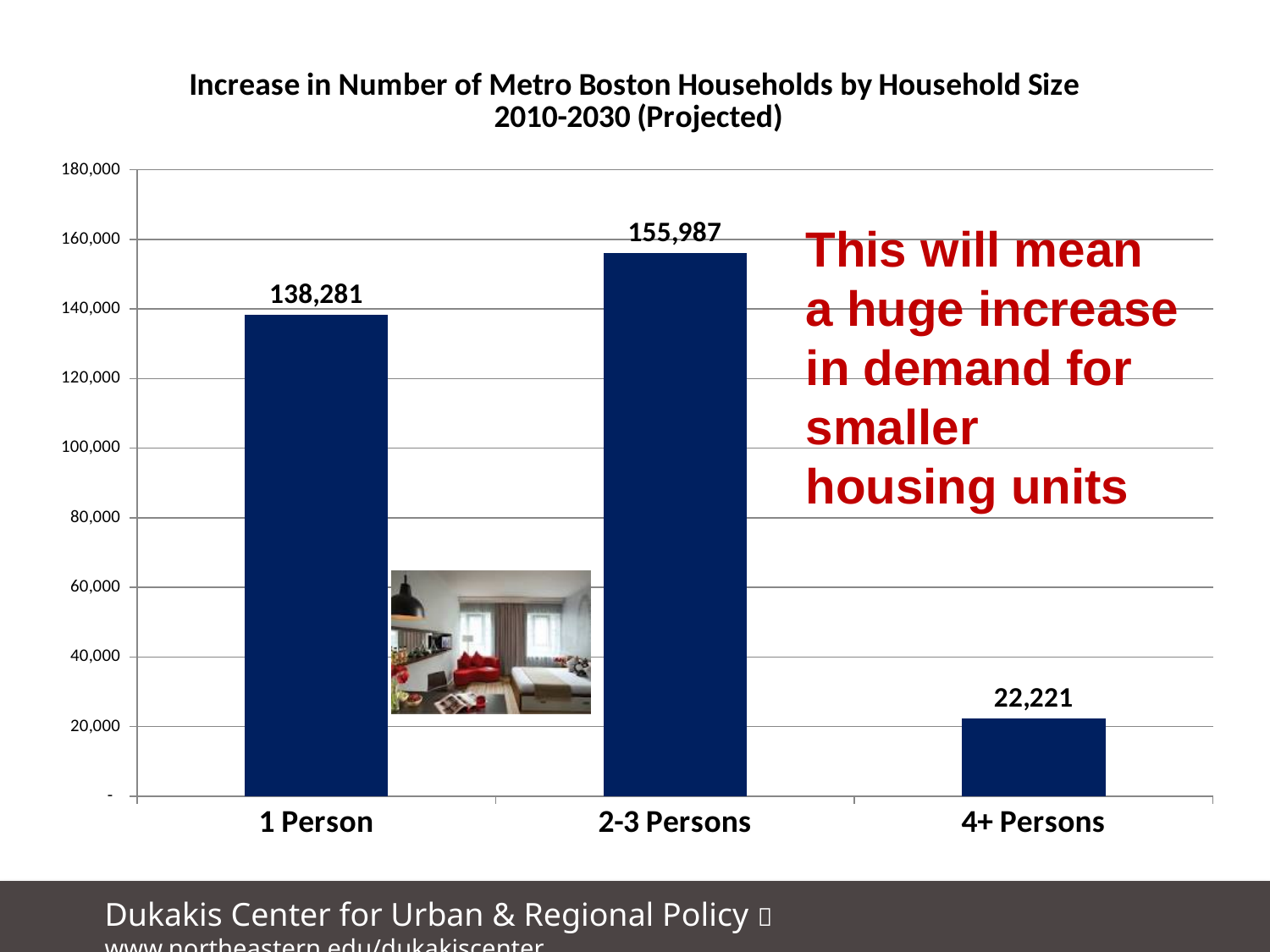
Is the value for 4+ Persons greater or less than 40,000? less What is the difference between the values for 2-3 Persons and 1 Person? 17,706 How many household size categories are shown on the chart? 3 What is the difference between the values for 1 Person and 4+ Persons? 116,060 Which household size category has the lowest value? 4+ Persons Which household size category has the highest value? 2-3 Persons What is the value for 4+ Persons? 22,221 What kind of chart is shown on the slide? bar chart What is the value for 1 Person? 138,281 Which is larger, the value for 1 Person or the value for 4+ Persons? 1 Person What is the value for 2-3 Persons? 155,987 What is the title of the chart? Increase in Number of Metro Boston Households by Household Size 2010-2030 (Projected)